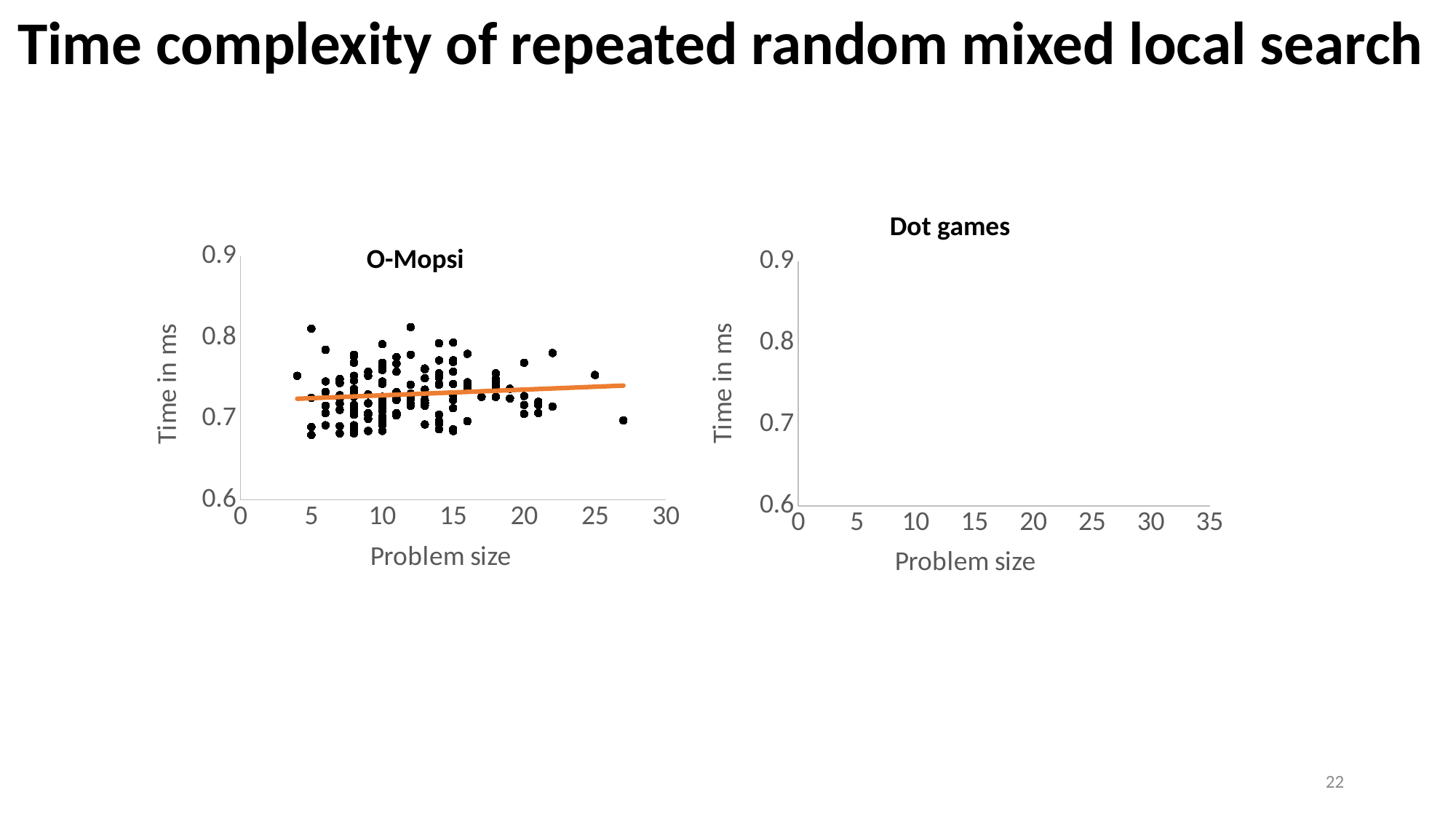
What is the title of the chart on the left of the slide? O-Mopsi In the O-Mopsi chart, is the value of the trend line at problem size 25 greater or less than 0.7? greater In the O-Mopsi chart, is the value of the trend line at problem size 5 greater or less than 0.8? less In the O-Mopsi chart, are all the plotted points greater or less than 0.6 ms? greater What is the y-axis label of the Dot games chart? Time in ms In the O-Mopsi chart, does the orange trend line rise or fall as problem size increases? rises What kind of chart is the O-Mopsi chart? scatter chart How many data points are plotted in the Dot games chart? 0